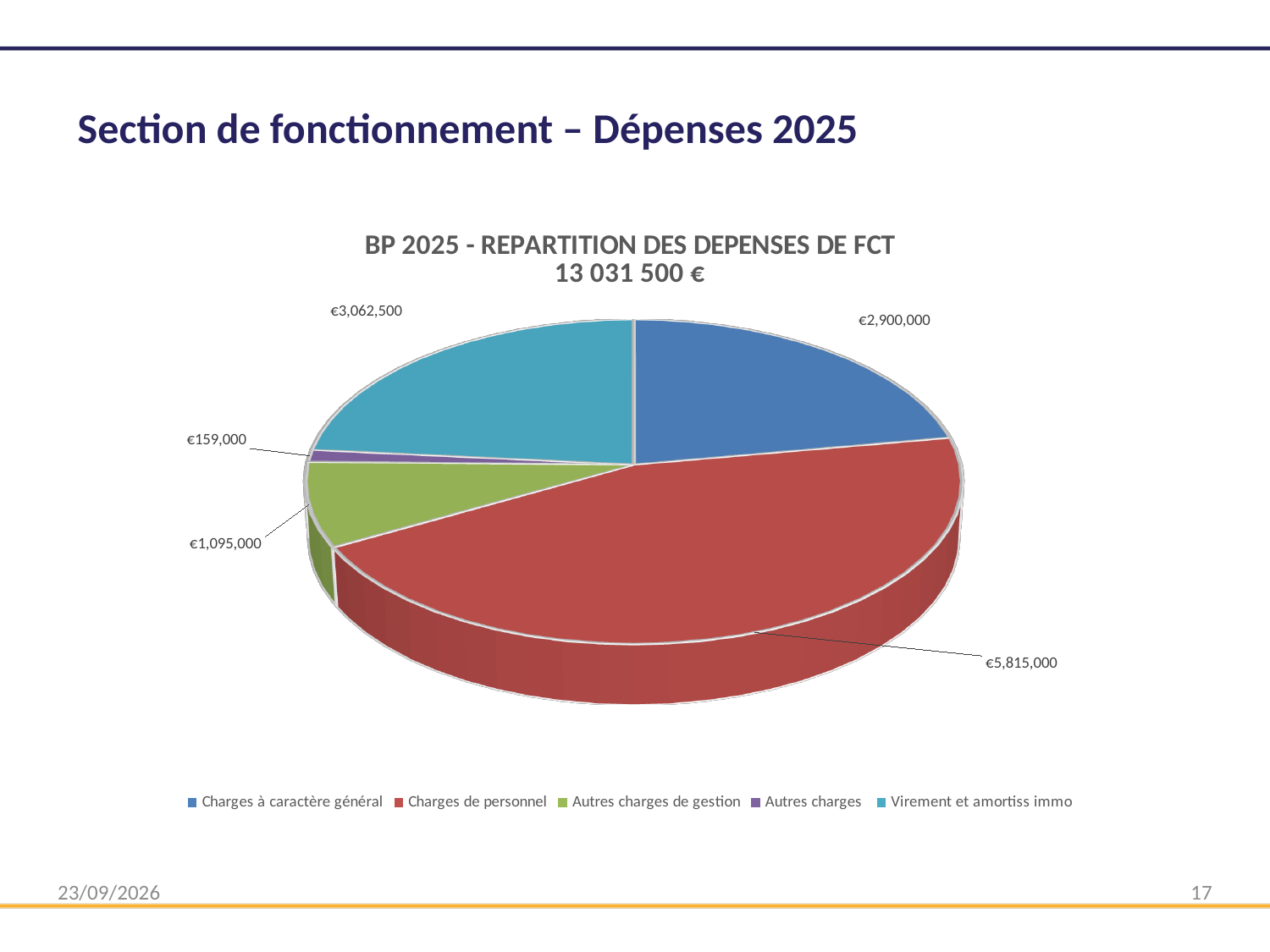
Which is larger, Virement et amortiss immo or Charges à caractère général? Virement et amortiss immo What type of chart is shown on the slide? Pie chart What is the value for Charges à caractère général? €2,900,000 Which category has the largest slice of the pie? Charges de personnel What is the value for Autres charges de gestion? €1,095,000 How many categories does the legend list? 5 What is the difference between Charges de personnel and Charges à caractère général? €2,915,000 Which category has the smallest slice of the pie? Autres charges What is the value for Charges de personnel? €5,815,000 What is the value for Virement et amortiss immo? €3,062,500 What total amount is shown in the chart title? 13 031 500 € What is the value for Autres charges? €159,000